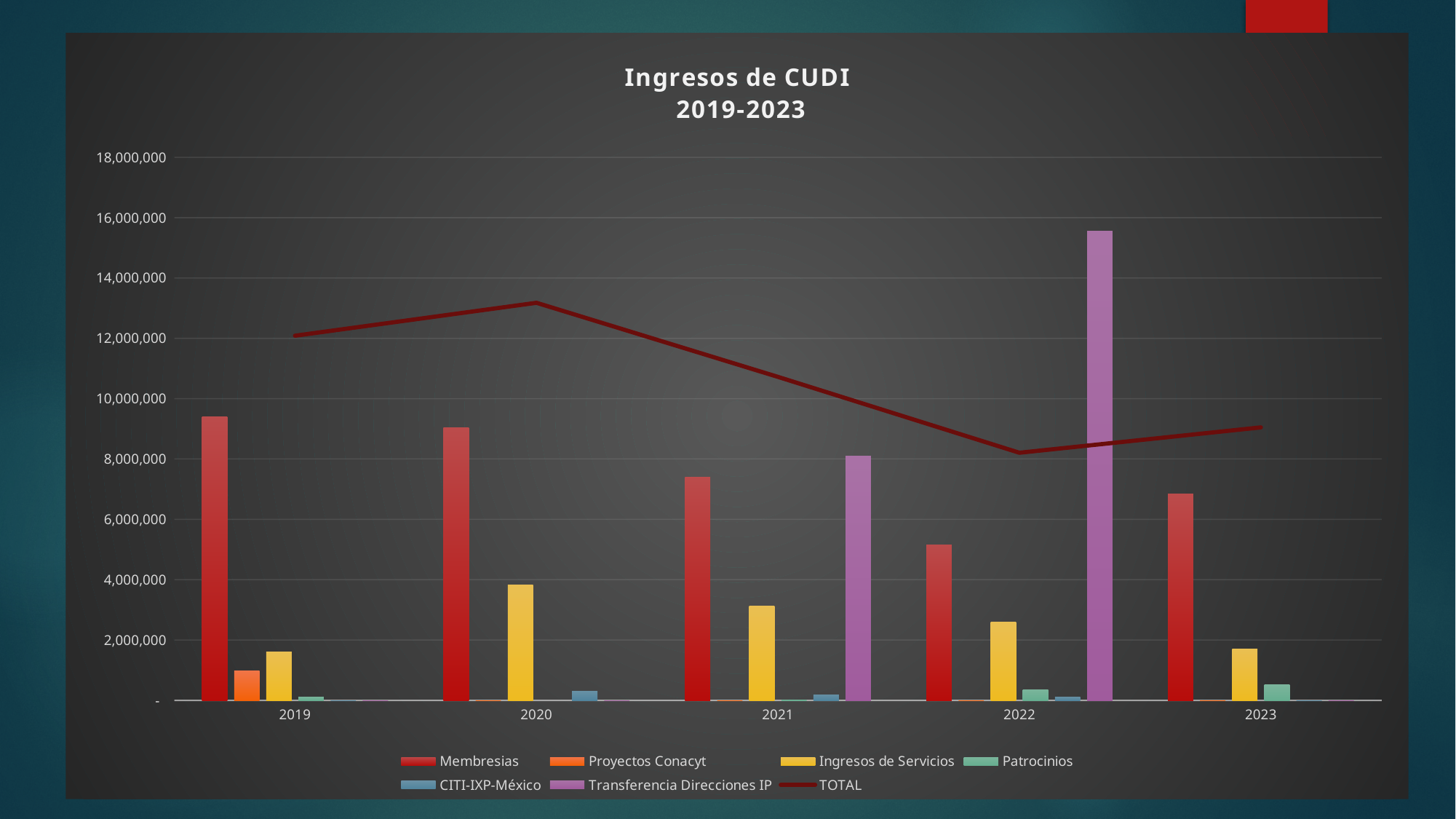
What kind of chart is shown on the slide? bar chart with a line In which year is the TOTAL line at its highest point? 2020 What is the title of the chart? Ingresos de CUDI 2019-2023 How many years are shown on the x axis? 5 Is the value for Transferencia Direcciones IP in 2022 greater or less than 14,000,000? greater Which is larger: Ingresos de Servicios in 2020 or Ingresos de Servicios in 2021? 2020 Is the value for Membresias in 2019 greater or less than 8,000,000? greater Is the TOTAL value in 2022 greater or less than 10,000,000? less How many series does the legend list? 7 In which year is the Membresias bar the lowest? 2022 In which year is the Ingresos de Servicios bar the highest? 2020 Between 2020 and 2022, does the TOTAL line rise or fall? fall